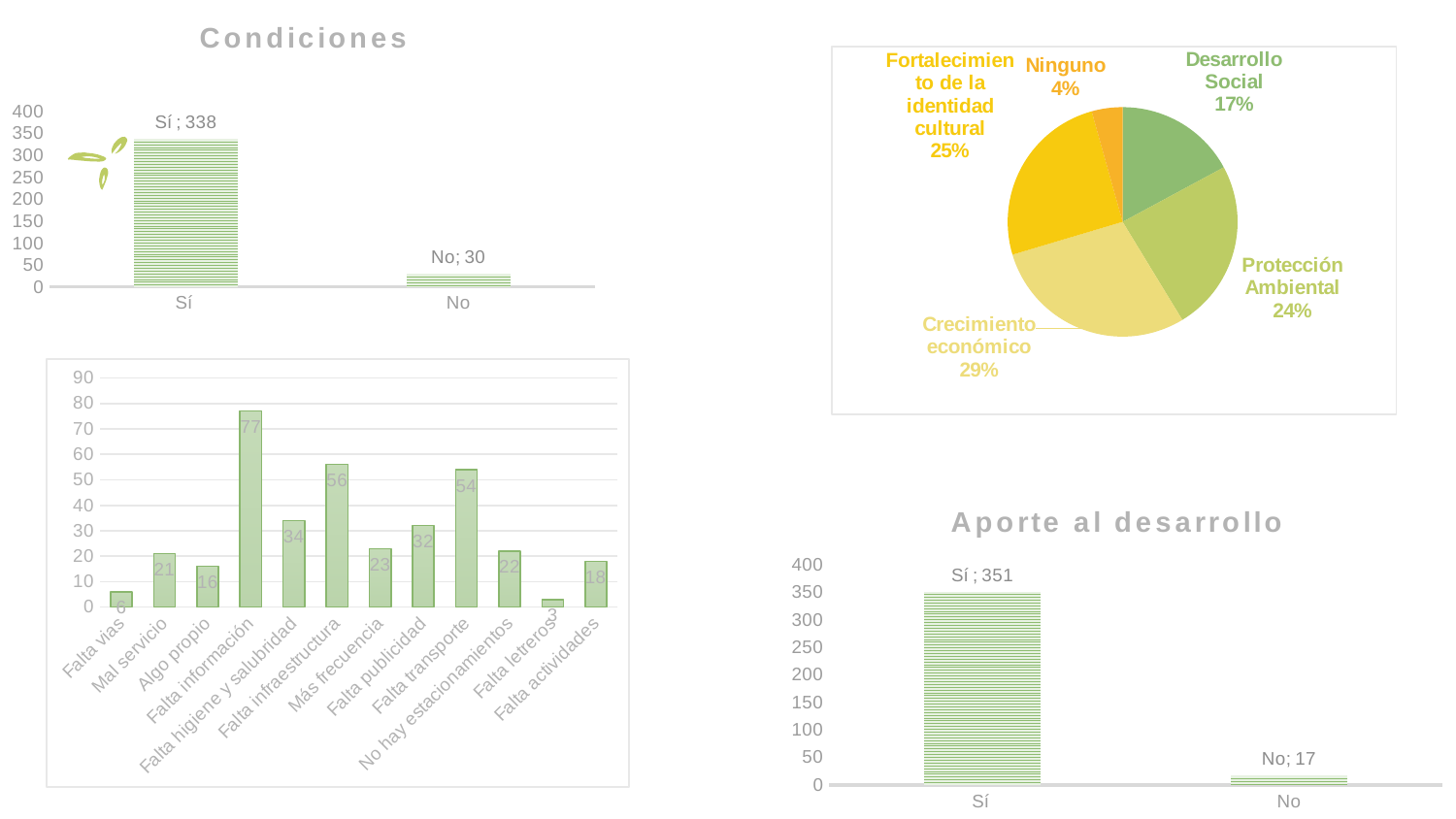
In the bottom-left bar chart, how many categories are shown on the x axis? 12 In the 'Condiciones' chart, what is the difference between the 'Sí' and 'No' values? 308 In the bottom-left bar chart, what is the value for 'Falta información'? 77 In the 'Condiciones' chart, what is the value for 'Sí'? 338 In the bottom-left bar chart, which is larger: 'Falta infraestructura' or 'Falta transporte'? Falta infraestructura In the pie chart at the top right, how many slices are there? 5 In the pie chart at the top right, which slice is the smallest? Ninguno In the 'Aporte al desarrollo' chart, which category is highest? Sí In the pie chart at the top right, what share does 'Crecimiento económico' have? 29% What kind of chart is the 'Aporte al desarrollo' chart? Bar chart In the 'Aporte al desarrollo' chart, what is the value for 'No'? 17 In the bottom-left bar chart, which category has the lowest value? Falta letreros